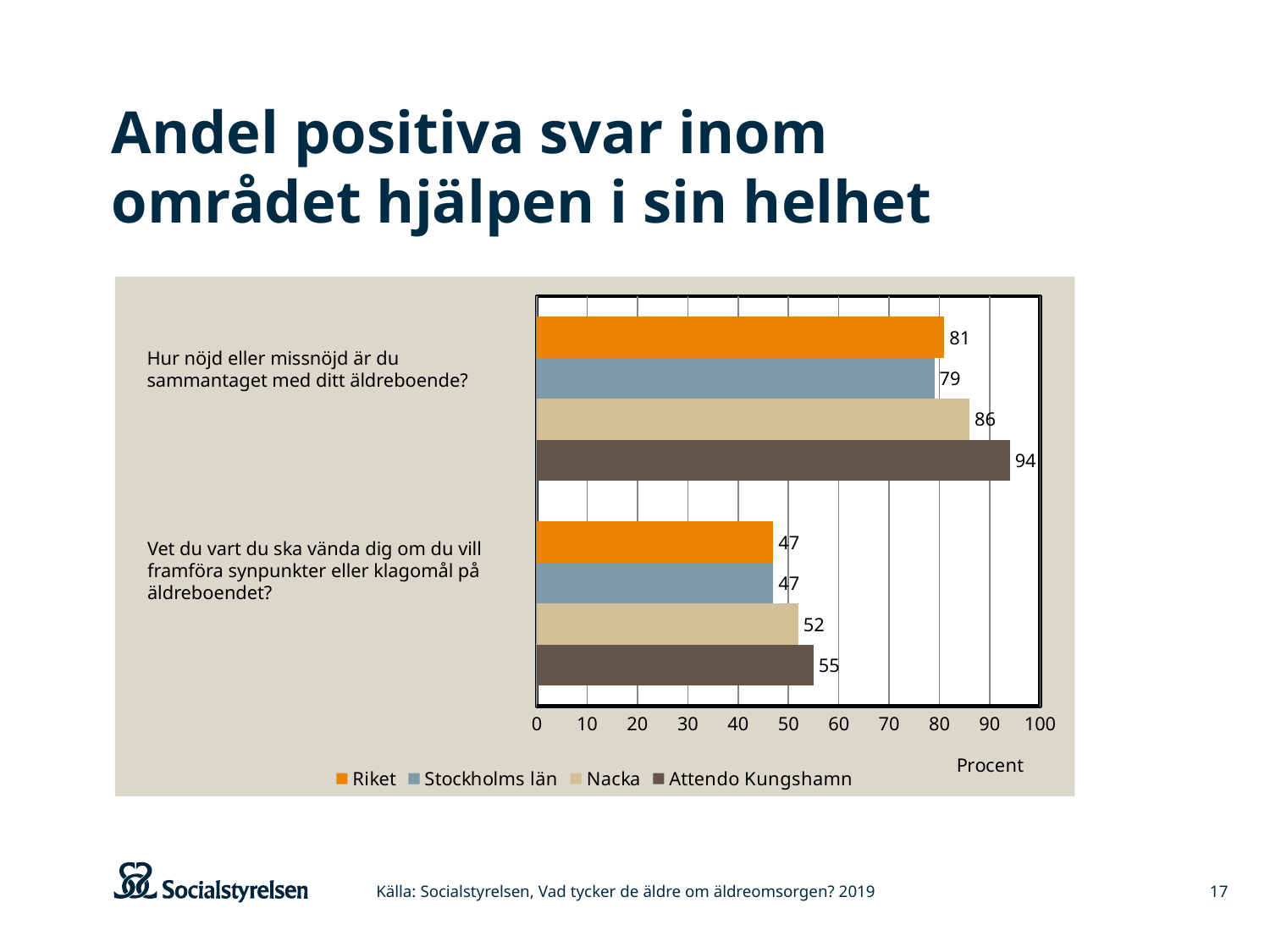
What is the value for Stockholms län on the question "Vet du vart du ska vända dig om du vill framföra synpunkter eller klagomål på äldreboendet?"? 47 What is the value for Nacka on the question "Hur nöjd eller missnöjd är du sammantaget med ditt äldreboende?"? 86 Which is larger on the question "Vet du vart du ska vända dig om du vill framföra synpunkter eller klagomål på äldreboendet?": Nacka or Riket? Nacka Which series has the lowest value on the question "Hur nöjd eller missnöjd är du sammantaget med ditt äldreboende?"? Stockholms län What is the difference between Attendo Kungshamn and Riket on the question "Hur nöjd eller missnöjd är du sammantaget med ditt äldreboende?"? 13 What is the difference between Attendo Kungshamn and Nacka on the question "Vet du vart du ska vända dig om du vill framföra synpunkter eller klagomål på äldreboendet?"? 3 What kind of chart is shown on the slide? Bar chart Which series has the highest value on the question "Hur nöjd eller missnöjd är du sammantaget med ditt äldreboende?"? Attendo Kungshamn How many series does the legend list? 4 What is the value for Riket on the question "Vet du vart du ska vända dig om du vill framföra synpunkter eller klagomål på äldreboendet?"? 47 What is the value for Attendo Kungshamn on the question "Hur nöjd eller missnöjd är du sammantaget med ditt äldreboende?"? 94 What is the label on the horizontal axis of the chart? Procent